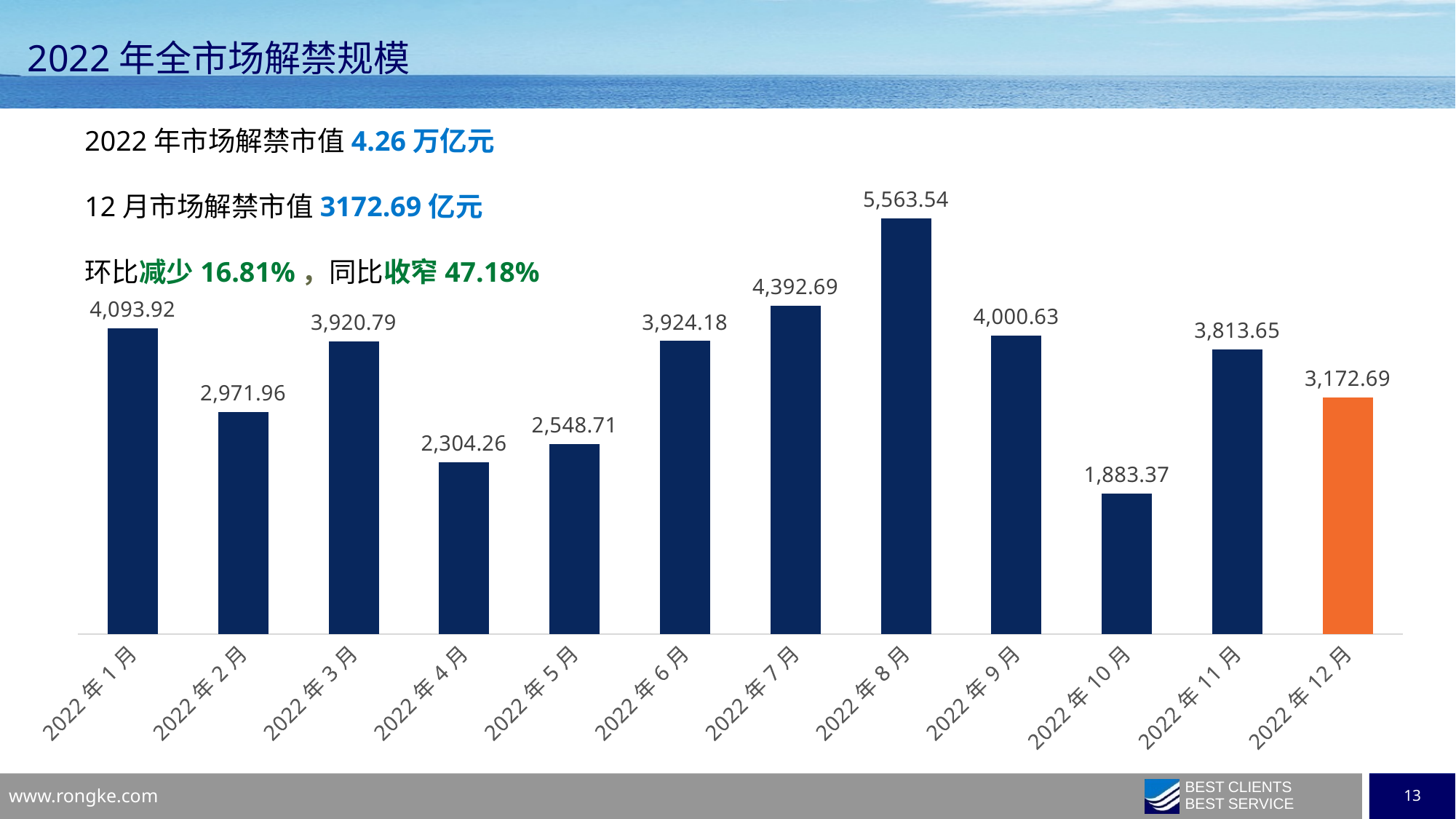
Which month has the highest value? 2022年8月 Which month has the lowest value? 2022年10月 Which bar is coloured orange instead of dark blue? 2022年12月 Which is larger, the value for 2022年4月 or 2022年5月? 2022年5月 What kind of chart is shown on the slide? Bar chart What is the difference between the values for 2022年11月 and 2022年12月? 640.96 What is the value for 2022年12月? 3,172.69 How many months are shown on the chart? 12 What is the value for 2022年4月? 2,304.26 What is the difference between the values for 2022年8月 and 2022年7月? 1,170.85 Which is larger, the value for 2022年7月 or 2022年9月? 2022年7月 What is the value for 2022年8月? 5,563.54